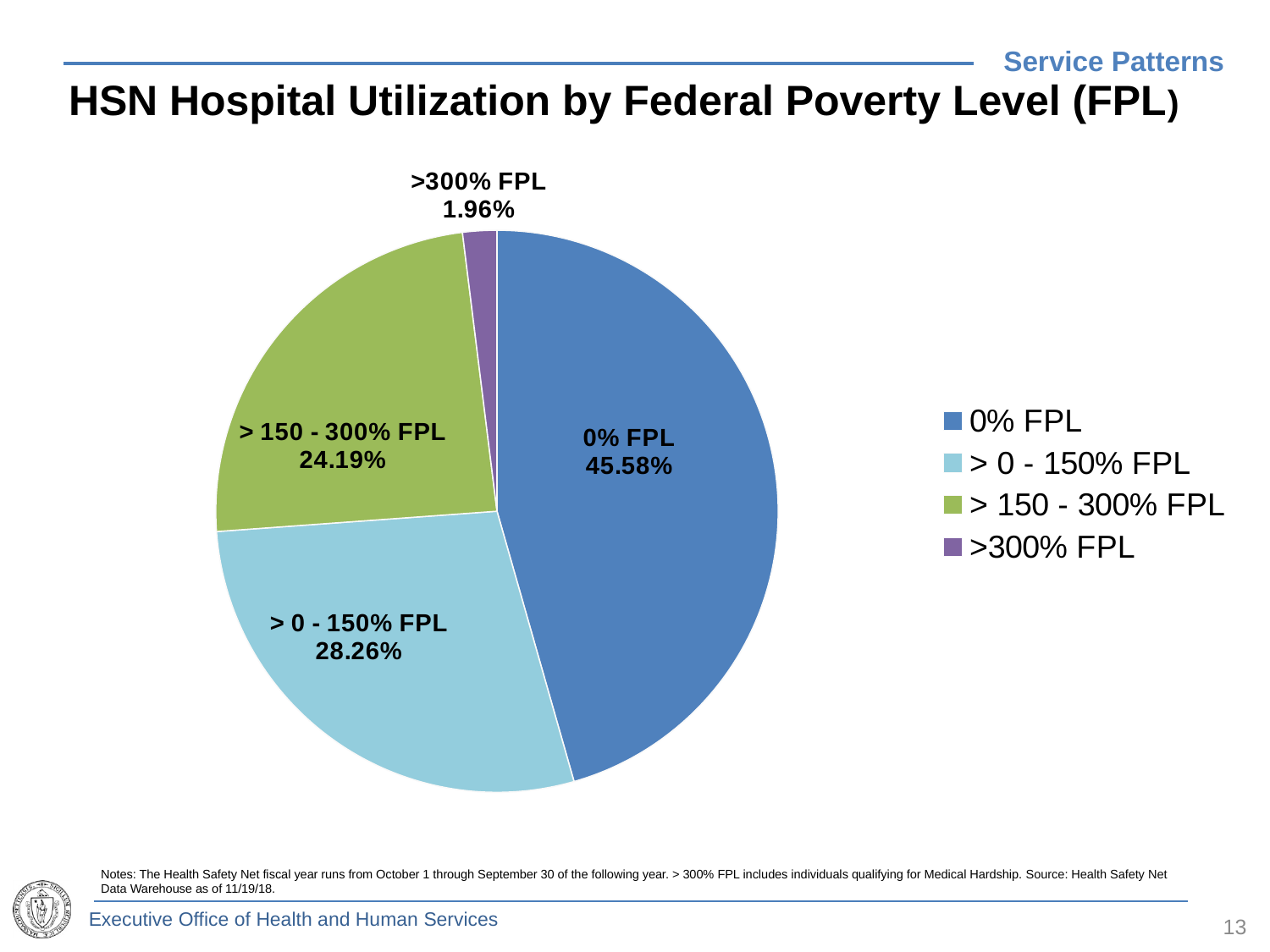
What kind of chart is shown on the slide? pie chart What is the difference in share between the 0% FPL group and the > 0 - 150% FPL group? 17.32% How many FPL categories are shown in the pie chart? 4 What share of HSN hospital utilization is for the >300% FPL group? 1.96% Which has a larger share, the > 0 - 150% FPL group or the > 150 - 300% FPL group? > 0 - 150% FPL What is the combined share of the > 150 - 300% FPL and >300% FPL groups? 26.15% Which FPL group has the largest share of HSN hospital utilization? 0% FPL What share of HSN hospital utilization is for the > 0 - 150% FPL group? 28.26% What is the title of the chart on the slide? HSN Hospital Utilization by Federal Poverty Level (FPL) What share of HSN hospital utilization is for the 0% FPL group? 45.58% Which FPL group has the smallest share of HSN hospital utilization? >300% FPL What share of HSN hospital utilization is for the > 150 - 300% FPL group? 24.19%